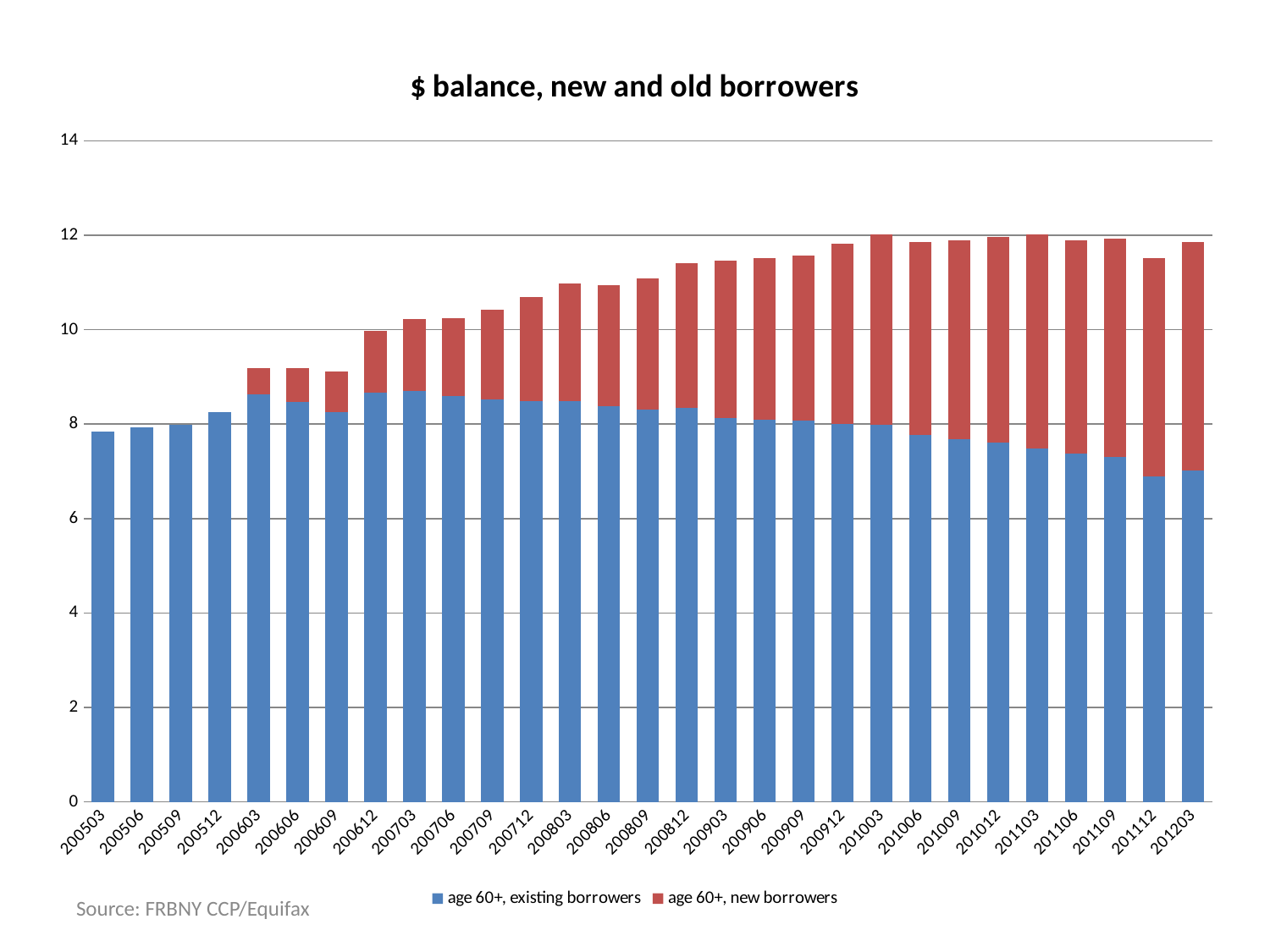
Is the value for 'age 60+, existing borrowers' at 201112 greater or less than 8? less Is the value for 'age 60+, existing borrowers' at 200503 greater or less than 8? less What is the title of the chart? $ balance, new and old borrowers How many series does the legend list? 2 Is the total stacked bar at 200603 greater or less than 10? less What kind of chart is shown on the slide? stacked bar chart How many time periods (bars) are shown along the x axis? 29 Which colour represents 'age 60+, new borrowers'? red Does the 'age 60+, existing borrowers' series rise or fall from 200703 to 201203? fall Which has the larger total stacked bar, 200503 or 201203? 201203